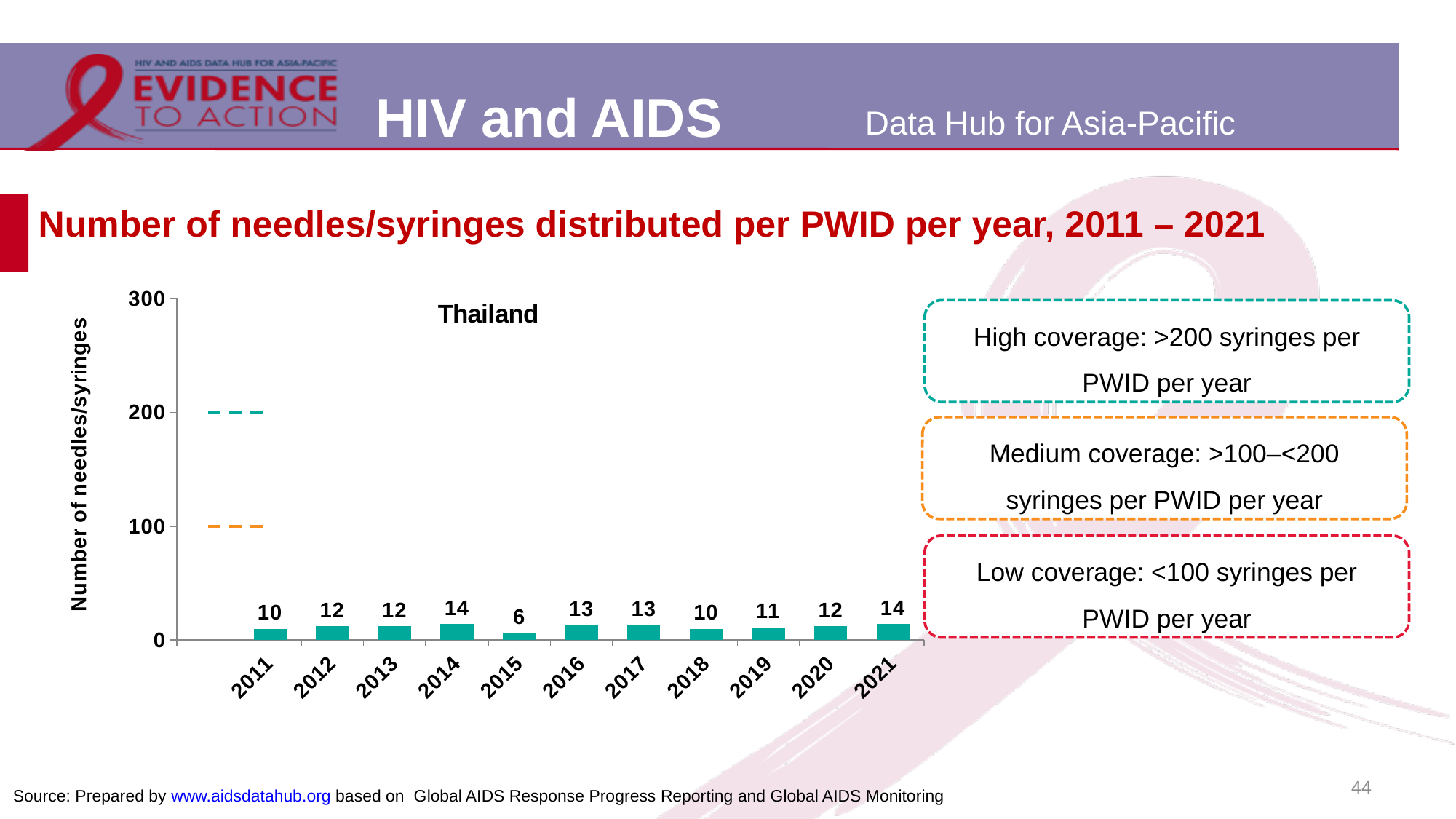
Which is larger, the value for 2016 or the value for 2018? 2016 What kind of chart is shown on the slide? bar chart How many years are plotted on the x axis? 11 What is the number of needles/syringes distributed per PWID in Thailand in 2015? 6 What is the label of the y axis? Number of needles/syringes What is the value shown for 2014? 14 What is the difference between the values for 2014 and 2015? 8 Which year has the lowest number of needles/syringes distributed per PWID? 2015 Which country does the chart show data for? Thailand What is the difference between the values for 2012 and 2019? 1 What is the value shown for 2011? 10 Is the value for 2021 greater or less than 100? less